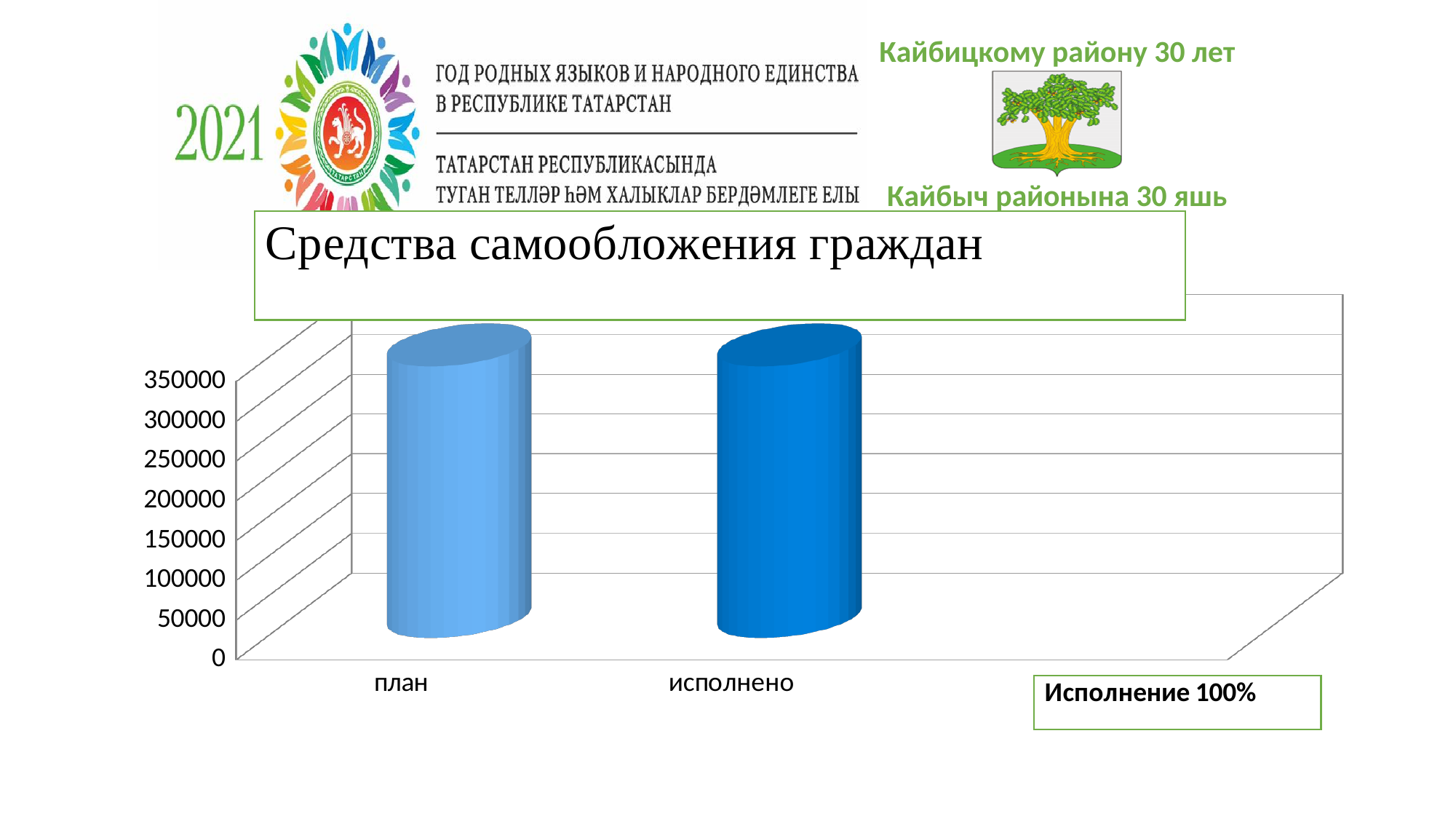
What is the title shown above the chart? Средства самообложения граждан What are the two category labels on the x axis of the chart? план, исполнено What kind of chart is shown on the slide? bar chart How many categories are shown on the x axis of the chart? 2 Is the value for исполнено greater or less than 150000? greater What is the highest tick value shown on the y axis of the chart? 350000 Is the value for план greater or less than 200000? greater Is the value for исполнено greater or less than 300000? greater